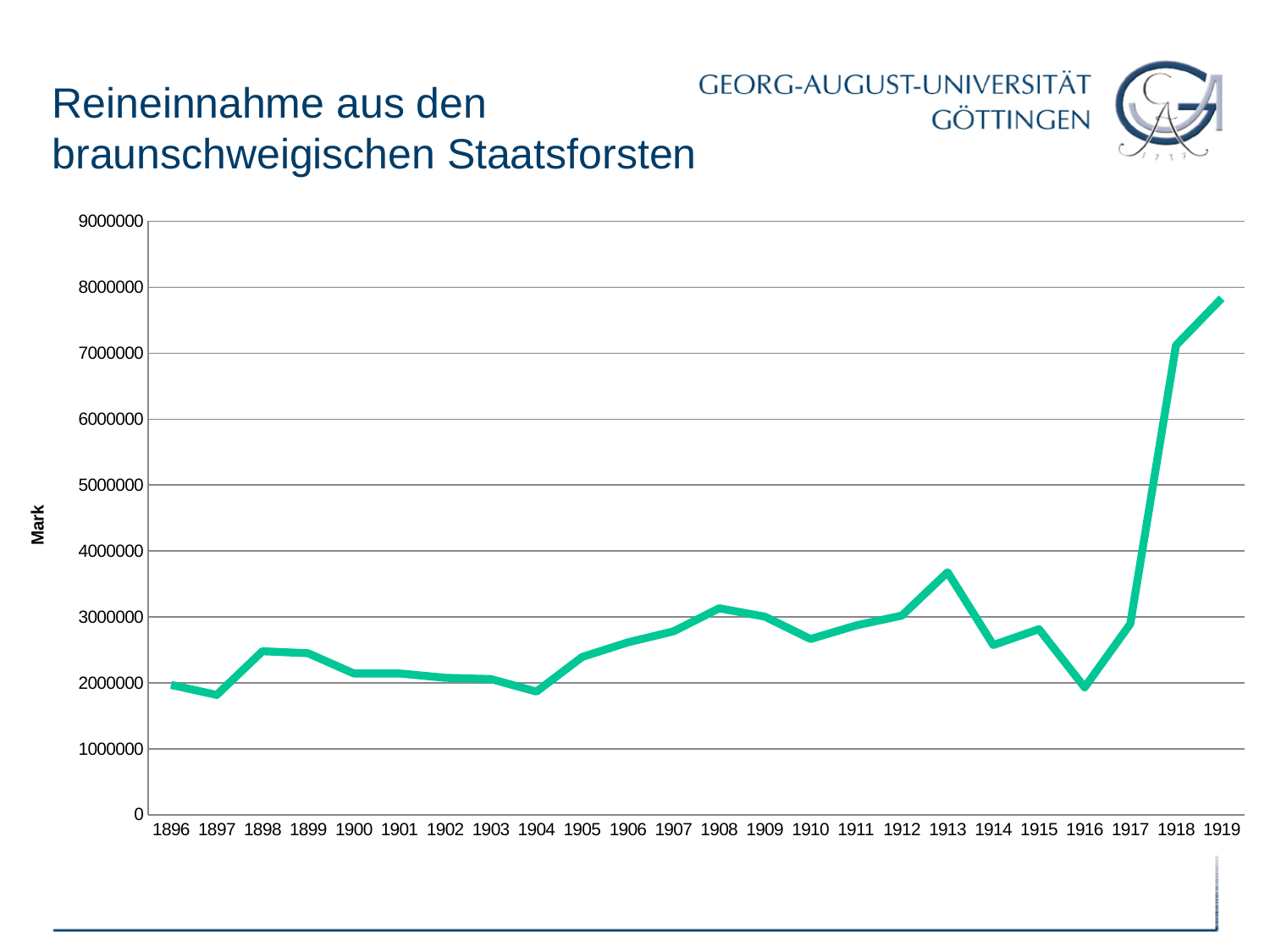
Is the value for 1919 greater or less than 7000000? greater Is the value for 1898 greater or less than 2000000? greater Which is larger, the value for 1913 or the value for 1914? 1913 What kind of chart is shown on the slide? line chart Do the values rise or fall from 1913 to 1916? fall Do the values rise or fall from 1916 to 1919? rise Is the value for 1910 greater or less than 3000000? less What is the label on the y axis? Mark How many years are plotted along the x axis? 24 Which year has the highest Reineinnahme? 1919 Which is larger, the value for 1896 or the value for 1919? 1919